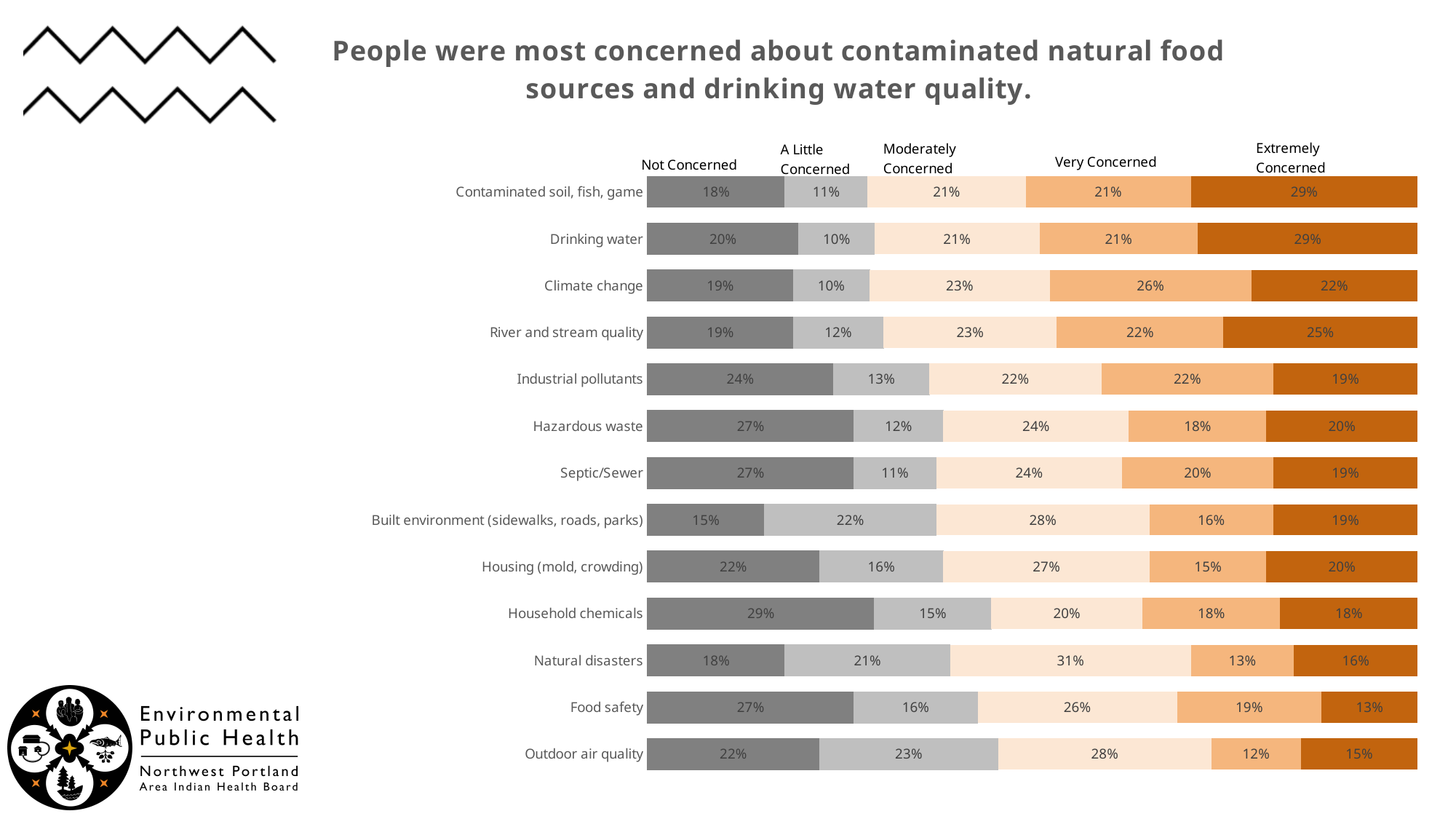
How many series does the chart show across the top (concern levels)? 5 What is the Extremely Concerned value for Drinking water? 29% How many environmental issue categories are listed in the chart? 13 Which is larger: the Very Concerned value for Climate change or the Very Concerned value for Outdoor air quality? Climate change What is the difference between the Extremely Concerned values for River and stream quality and Industrial pollutants? 6% Which category has the lowest Extremely Concerned value? Food safety Which category has the highest Very Concerned value? Climate change What is the Not Concerned value for Built environment (sidewalks, roads, parks)? 15% What is the title of the chart? People were most concerned about contaminated natural food sources and drinking water quality. What is the Moderately Concerned value for Natural disasters? 31% What kind of chart is shown on the slide? Stacked bar chart Which category has the highest Not Concerned value? Household chemicals